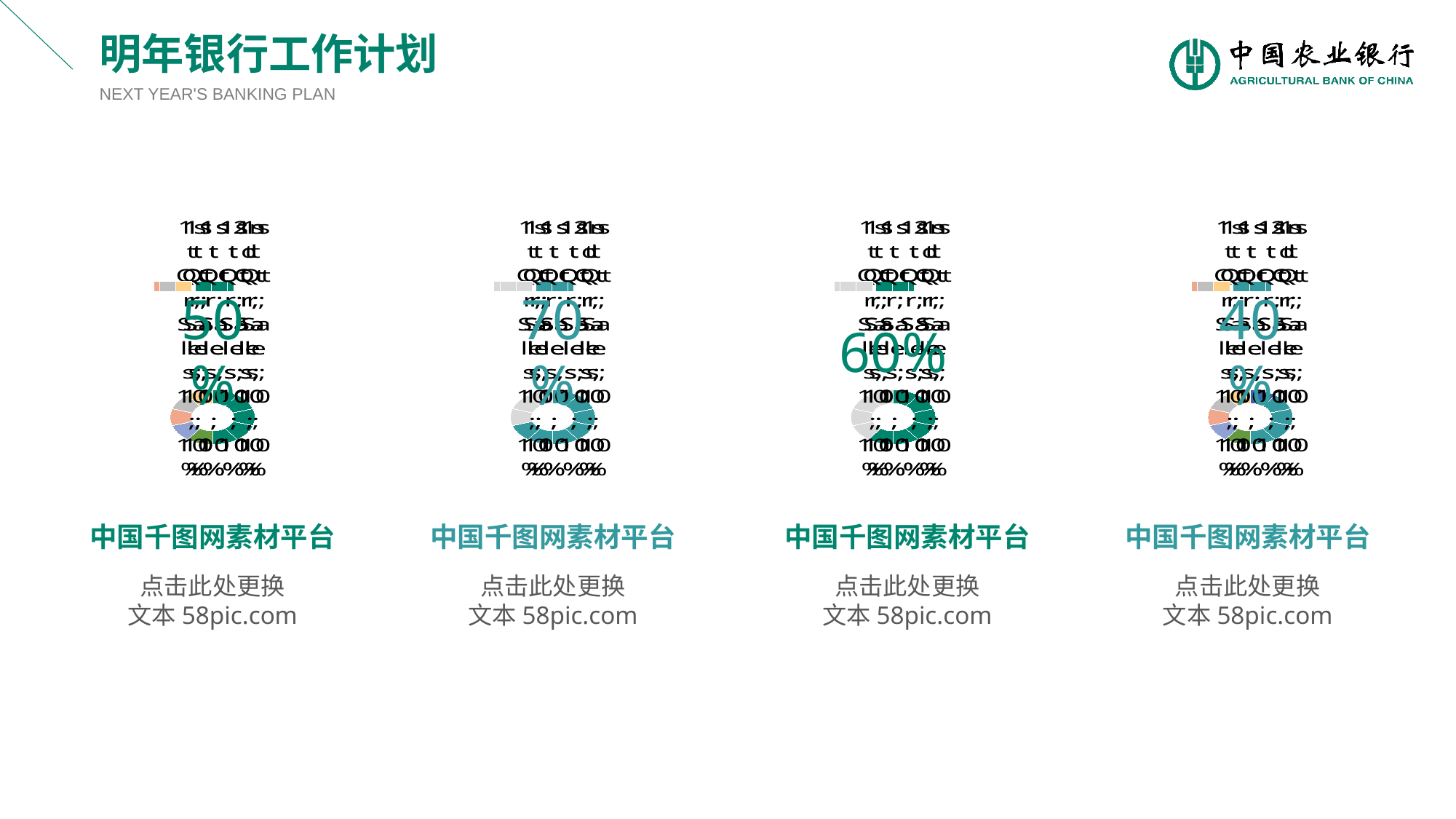
Which has the larger centre percentage, the first chart or the third chart? The third chart (60%) What percentage is shown in the centre of the second doughnut chart from the left? 70% What is the difference between the centre percentages of the second chart (70%) and the fourth chart (40%)? 30% Which of the four doughnut charts shows the highest centre percentage? The second chart from the left (70%) Is the centre percentage of the third chart greater or less than 50%? greater Which of the four doughnut charts shows the lowest centre percentage? The rightmost chart (40%) What is the title of the slide containing the four doughnut charts? 明年银行工作计划 What percentage is shown in the centre of the third doughnut chart from the left? 60% What percentage is shown in the centre of the first (leftmost) doughnut chart? 50% How many doughnut charts are on the slide? 4 What percentage is shown in the centre of the fourth (rightmost) doughnut chart? 40% What kind of chart is used for each of the four charts on the slide? Doughnut chart